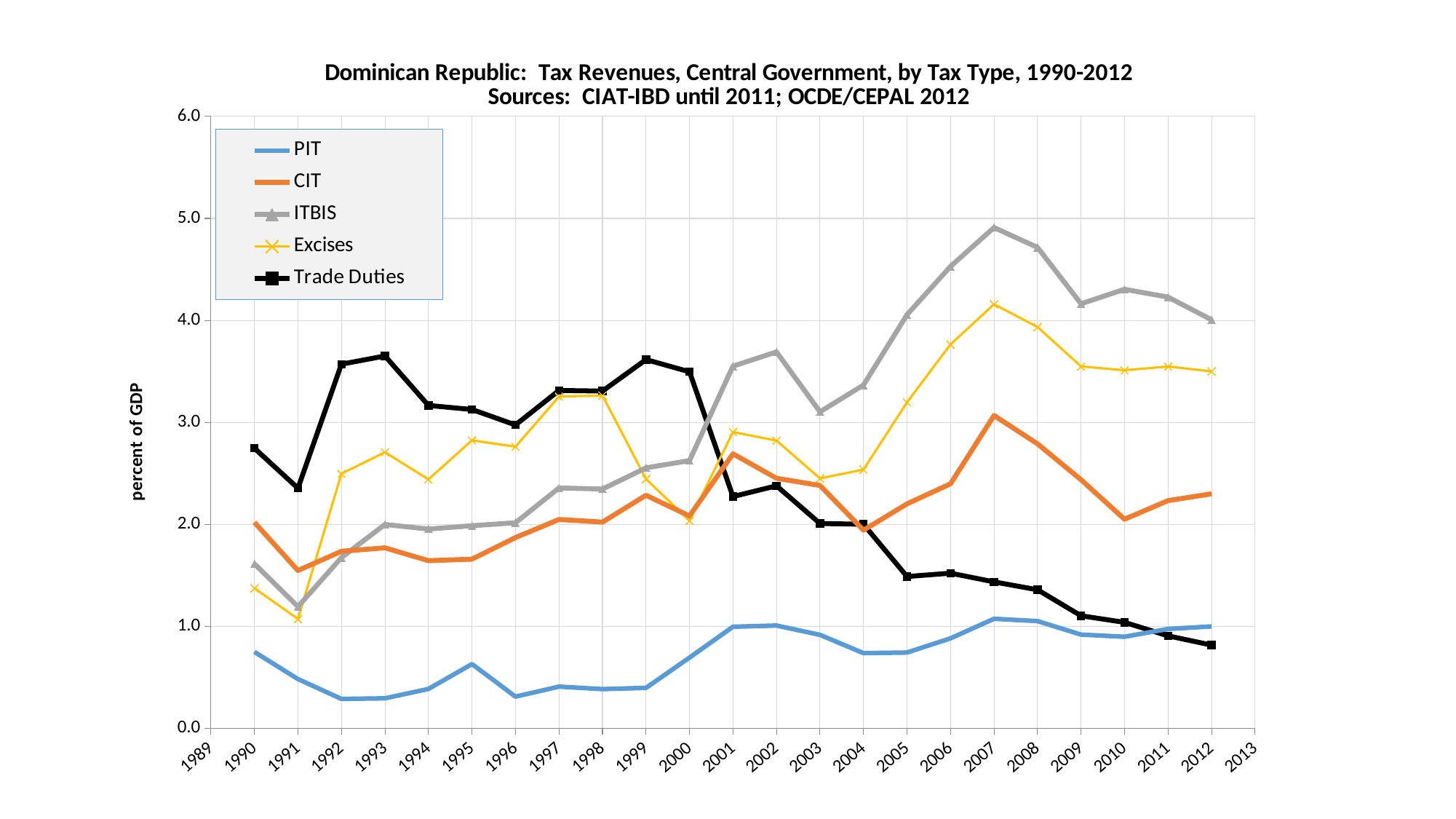
Which series has the lowest value in 2012? Trade Duties Is the value for Trade Duties in 2012 greater or less than 1.0? less What kind of chart is shown on the slide? line chart Is the value for Excises in 2006 greater or less than 3.0? greater Is the value for PIT in 1992 greater or less than 1.0? less What is the label on the vertical axis? percent of GDP Which series has the highest value in 2007? ITBIS How many series does the legend list? 5 Which series has the highest value in 1993? Trade Duties What are the series names listed in the legend? PIT, CIT, ITBIS, Excises, Trade Duties Do the values for Trade Duties rise or fall from 2000 to 2012? fall